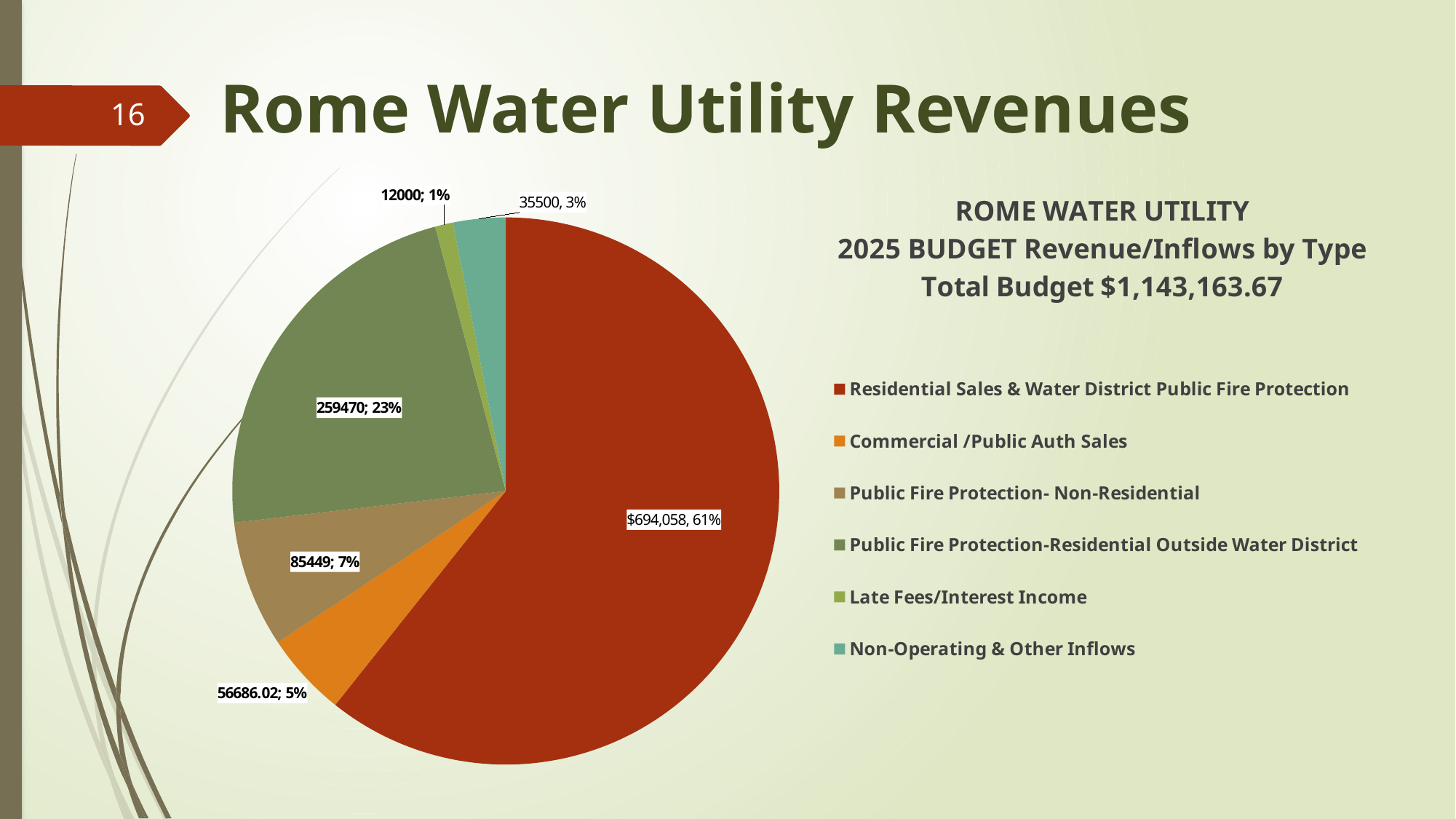
How many slices does the pie chart have? 6 Which category has the smallest slice of the pie? Late Fees/Interest Income Which category has the largest slice of the pie? Residential Sales & Water District Public Fire Protection Which is larger, Public Fire Protection- Non-Residential or Commercial /Public Auth Sales? Public Fire Protection- Non-Residential How many entries does the legend list? 6 What value is shown for Public Fire Protection-Residential Outside Water District? 259470 What value is shown for Late Fees/Interest Income? 12000 What share of the pie does Residential Sales & Water District Public Fire Protection represent? 61% What share of the pie does Public Fire Protection- Non-Residential represent? 7% What value is shown for Commercial /Public Auth Sales? 56686.02 What share of the pie does Non-Operating & Other Inflows represent? 3% What kind of chart is shown on the slide? Pie chart